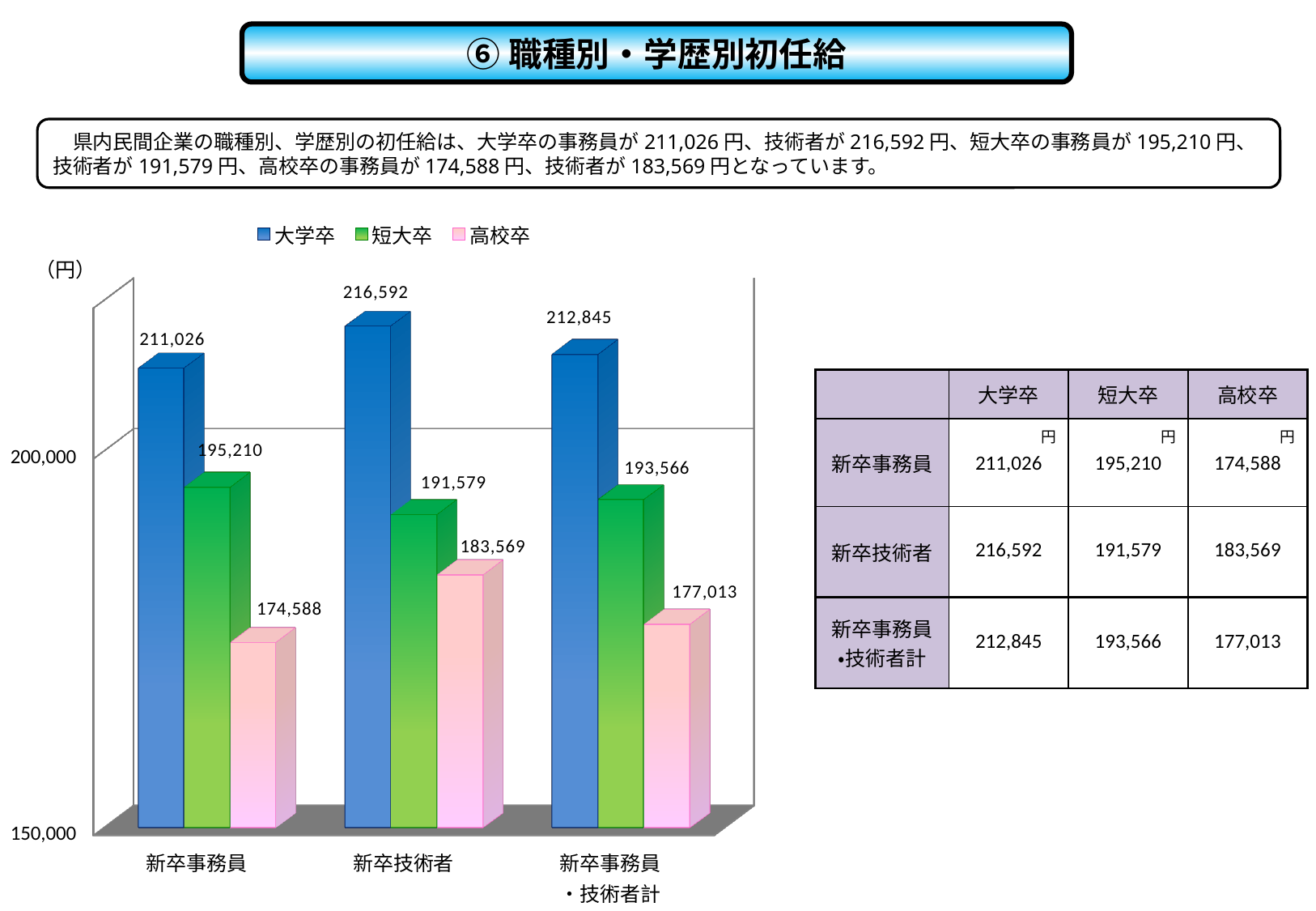
What is the difference between the 短大卒 values for 新卒事務員 and 新卒技術者? 3,631 What is the value for 大学卒 in the 新卒事務員 category? 211,026 Which category has the lowest 高校卒 value? 新卒事務員 Which is larger: the 短大卒 value for 新卒事務員 or the 短大卒 value for 新卒技術者? 新卒事務員 How many categories are shown on the x axis? 3 Is the 短大卒 value for 新卒技術者 greater or less than 200,000? less What is the value for 短大卒 in the 新卒事務員・技術者計 category? 193,566 Which category has the highest 大学卒 value? 新卒技術者 What is the value for 高校卒 in the 新卒技術者 category? 183,569 What kind of chart is shown on the slide? bar chart How many series does the legend list? 3 What is the difference between the 大学卒 and 高校卒 values for 新卒事務員? 36,438